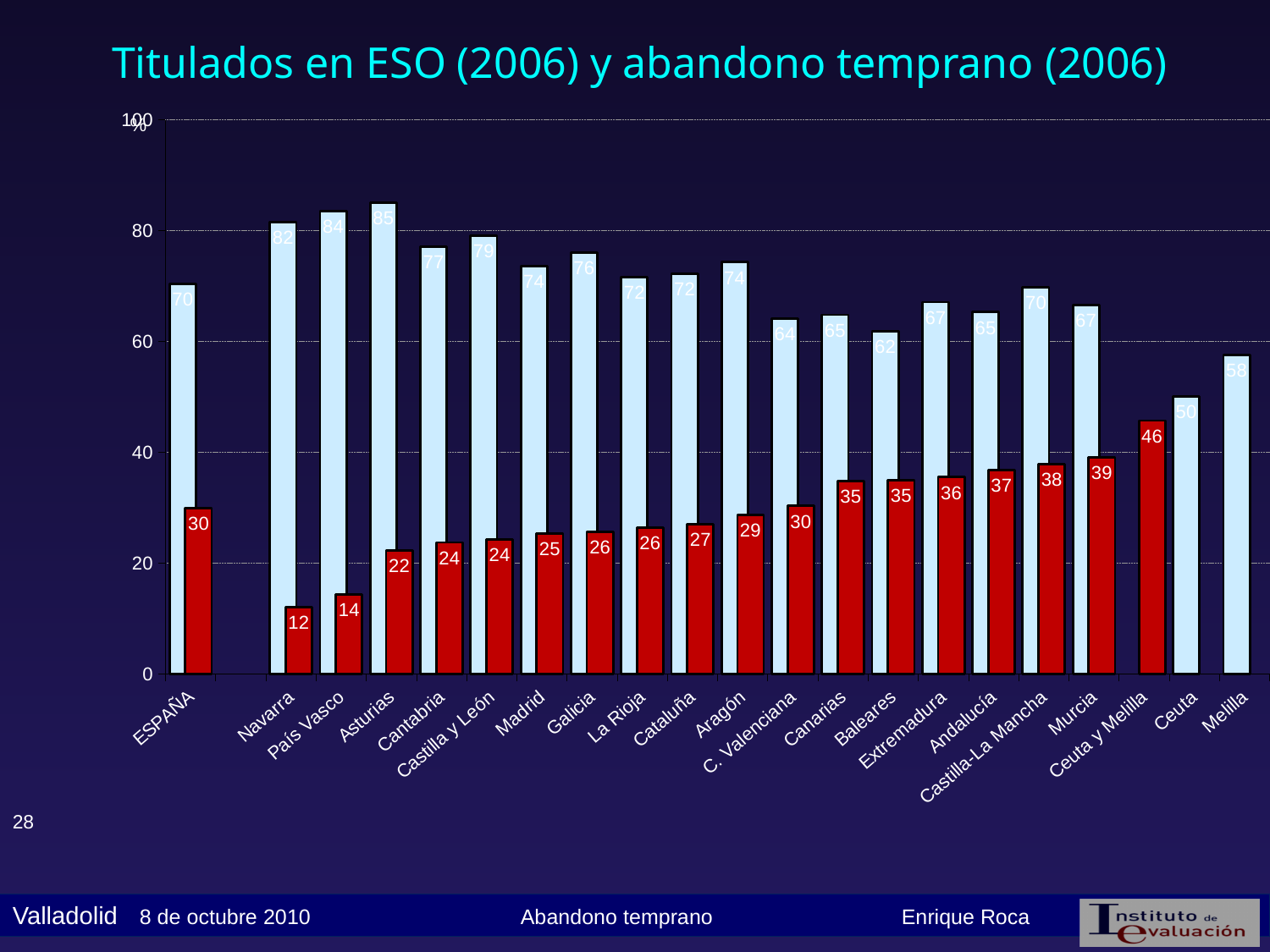
Which is larger: the red bar for Murcia or the red bar for Andalucía? Murcia What type of chart is shown on the slide? bar chart Which category has the lowest red bar? Navarra What is the title of the chart? Titulados en ESO (2006) y abandono temprano (2006) Which category has the highest light blue bar? Asturias What is the difference between the light blue bar for País Vasco and the light blue bar for Melilla? 26 Is the value of the light blue bar for Ceuta greater or less than 60? less Which category has the highest red bar? Ceuta y Melilla What is the value of the red bar for ESPAÑA? 30 What is the value of the light blue bar for Asturias? 85 What is the value of the light blue bar for Baleares? 62 What is the value of the red bar for Navarra? 12